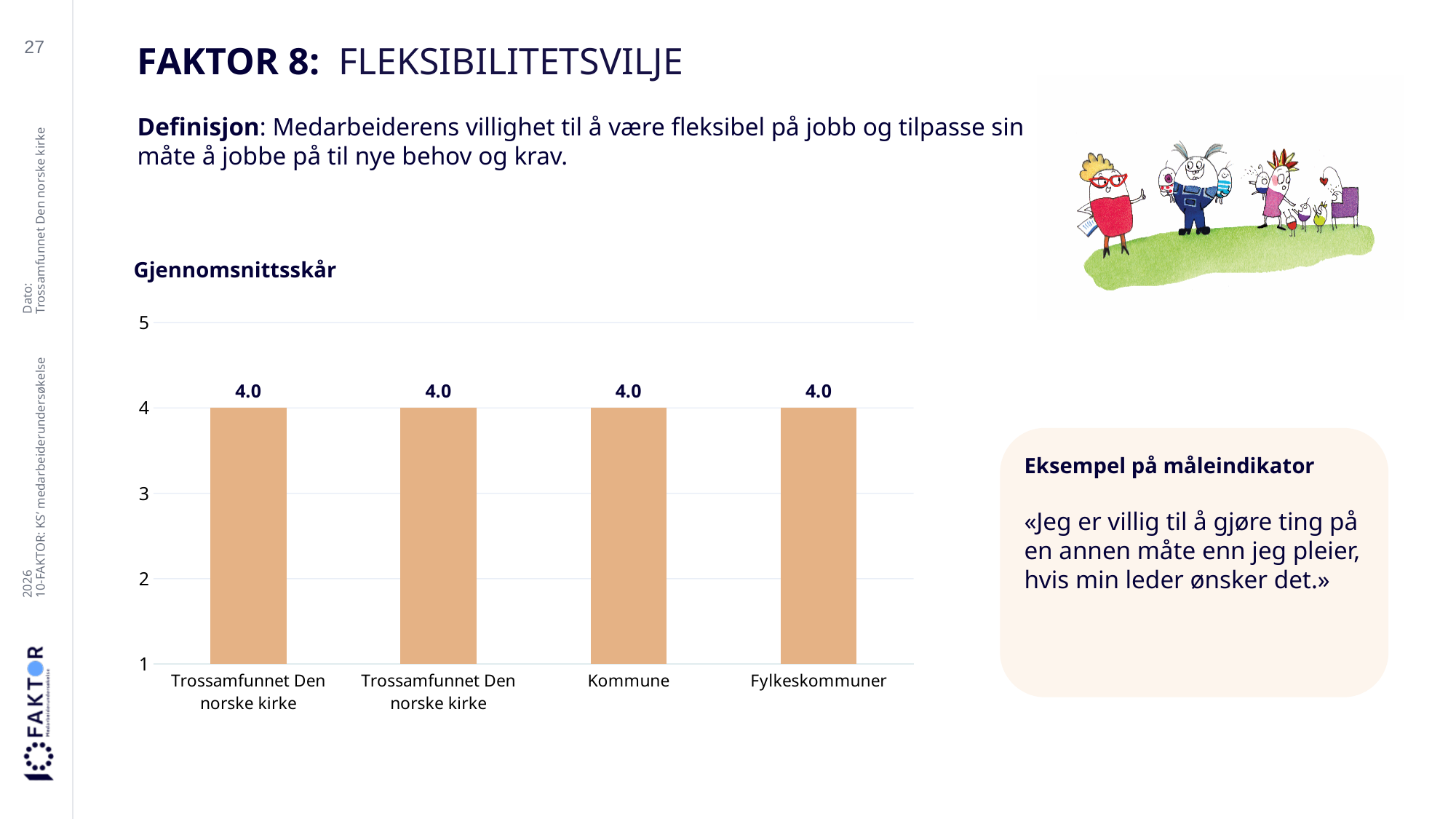
What is the value shown for the first bar, Trossamfunnet Den norske kirke? 4.0 How many bars are plotted in the chart? 4 What kind of chart is shown on the slide? Bar chart Is the value for Kommune greater or less than 3? greater What is the value for Kommune? 4.0 What is the title of the chart? Gjennomsnittsskår Is the value for Fylkeskommuner greater or less than 5? less What is the highest value shown on the vertical axis? 5 What is the difference between the values for Kommune and Fylkeskommuner? 0.0 What is the value for Fylkeskommuner? 4.0 Do the values rise, fall or stay flat across the categories from left to right? Stay flat